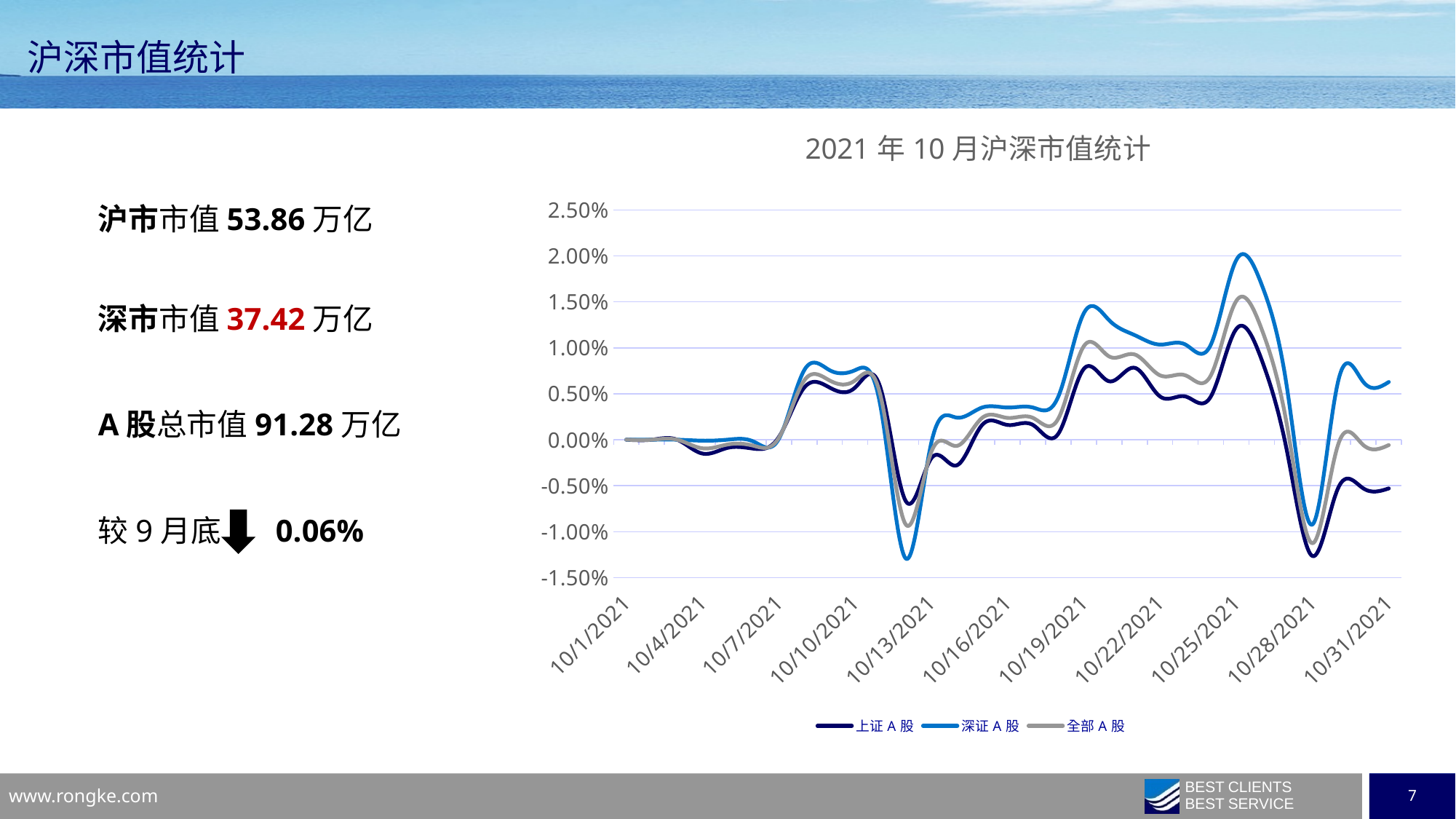
How many date labels are shown on the x axis? 11 Is the value for 深证 A 股 around 10/13/2021 greater or less than -1.00%? less Between 10/25/2021 and 10/28/2021, do the series rise or fall? fall Around 10/19/2021, which series is higher: 上证 A 股 or 深证 A 股? 深证 A 股 How many series does the chart legend list? 3 Which series is drawn in grey in the chart? 全部 A 股 At 10/31/2021, which series is higher: 上证 A 股 or 深证 A 股? 深证 A 股 What is the title of the chart? 2021 年 10 月沪深市值统计 What kind of chart is shown on the slide? line chart Is the value for 上证 A 股 around 10/25/2021 greater or less than 1.00%? greater Is the value for 全部 A 股 around 10/25/2021 greater or less than 1.00%? greater Which series reaches the highest peak in the chart? 深证 A 股